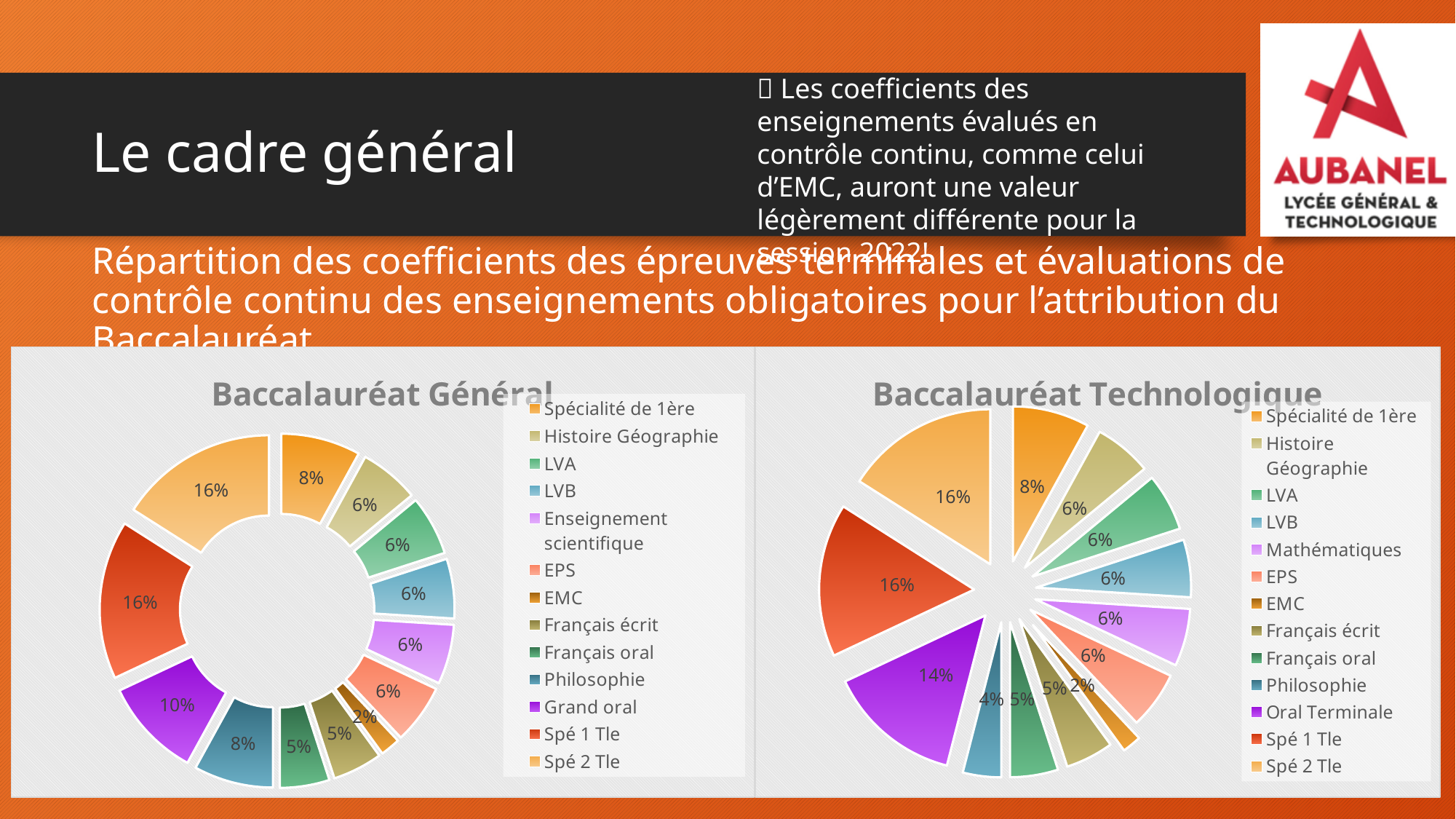
In the Baccalauréat Général chart, what is the difference between the shares of Grand oral and Philosophie? 2 percentage points In the Baccalauréat Technologique chart, what share does Philosophie have? 4% How many slices does the Baccalauréat Technologique chart have? 13 In the Baccalauréat Général chart, which category has the smallest share? EMC In the Baccalauréat Technologique chart, what share does Oral Terminale have? 14% In the Baccalauréat Général chart, what share does Philosophie have? 8% In the Baccalauréat Technologique chart, what share does EMC have? 2% How many entries does the legend of the Baccalauréat Général chart list? 13 Which is larger: Grand oral in the Baccalauréat Général chart or Oral Terminale in the Baccalauréat Technologique chart? Oral Terminale in the Baccalauréat Technologique chart In the Baccalauréat Général chart, what share does Grand oral have? 10% What kind of chart is the Baccalauréat Général chart? Pie chart (doughnut) Which legend entry in the Baccalauréat Technologique chart replaces Enseignement scientifique from the Baccalauréat Général chart? Mathématiques